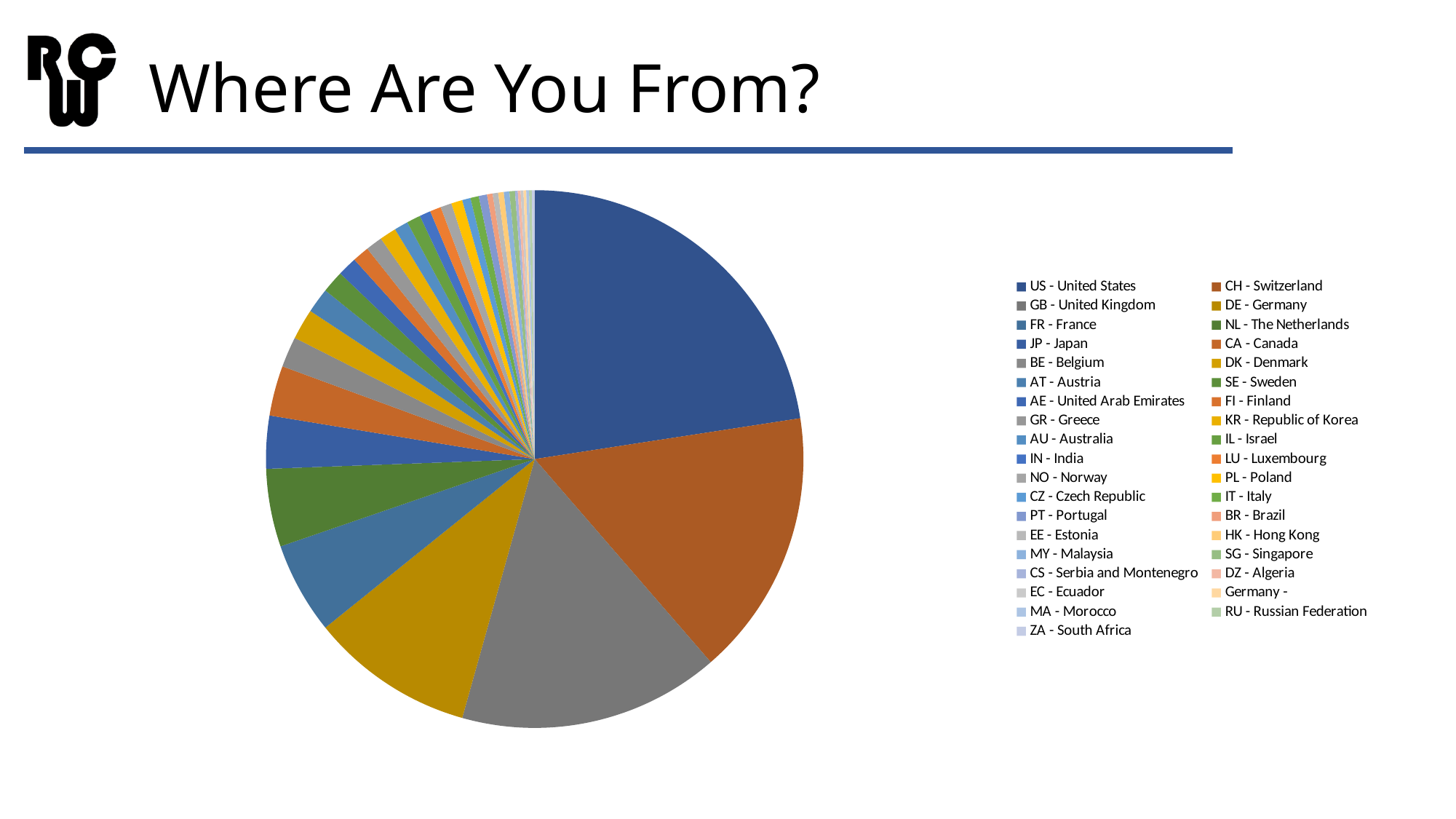
Which slice is larger, FR - France or JP - Japan? FR - France What is the title of the slide containing the pie chart? Where Are You From? Which country has the largest slice of the pie? US - United States Which slice is larger, GB - United Kingdom or US - United States? US - United States What kind of chart is shown on the slide? pie chart Which slice is larger, DE - Germany or NL - The Netherlands? DE - Germany What colour is the slice for US - United States? blue How many categories does the legend list? 37